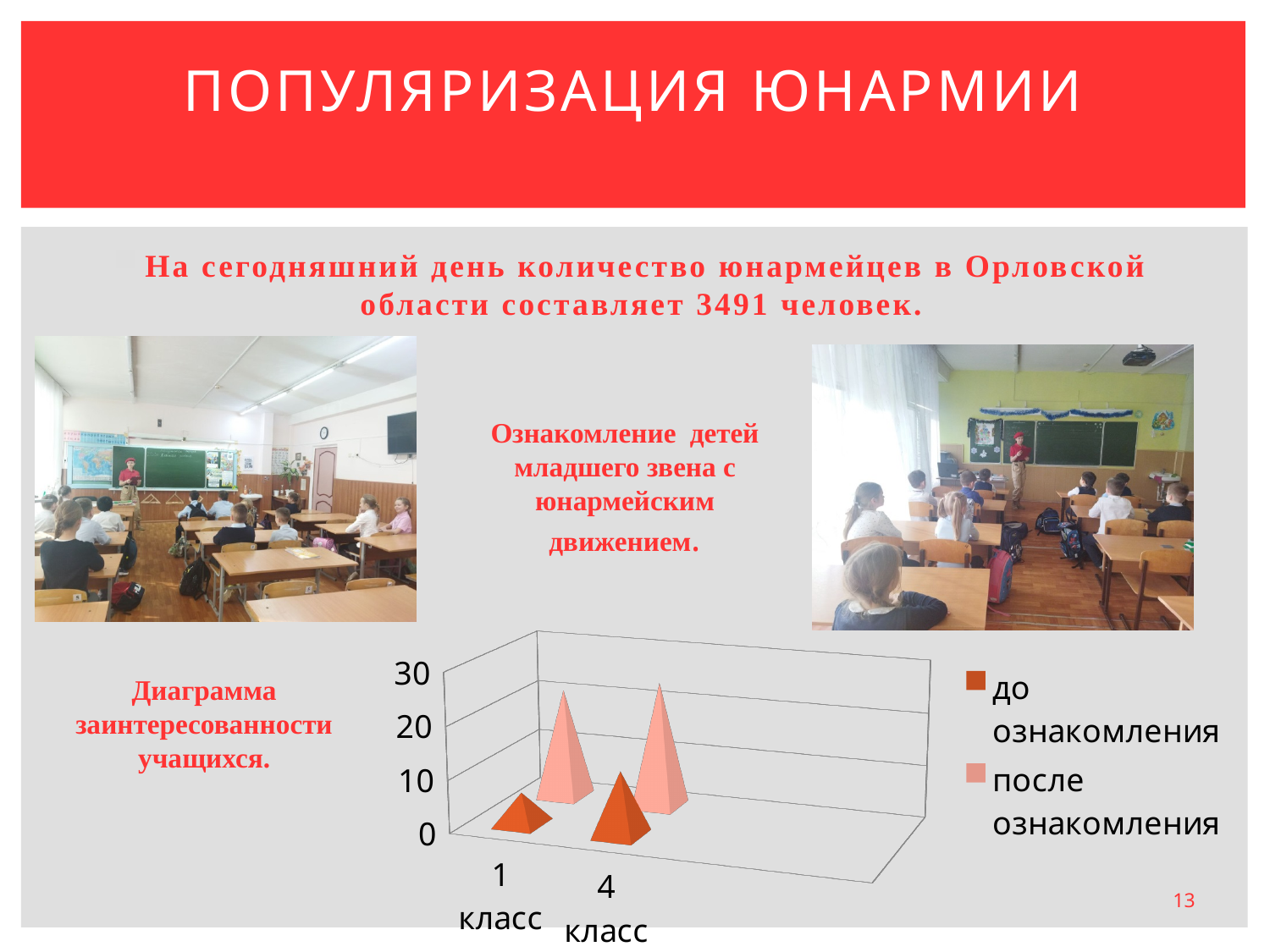
For 4 класс, which is larger: до ознакомления or после ознакомления? после ознакомления Which class has the higher value for до ознакомления? 4 класс What caption is given for the chart on the left side of the slide? Диаграмма заинтересованности учащихся. For 1 класс, which is larger: до ознакомления or после ознакомления? после ознакомления Is the value for после ознакомления in 1 класс greater or less than 10? greater How many categories (classes) are shown on the x axis of the chart? 2 Which two series are listed in the chart legend? до ознакомления, после ознакомления Which bar in the chart is the lowest? до ознакомления, 1 класс How many series does the chart legend list? 2 What kind of chart is shown on the slide? bar chart Is the value for до ознакомления in 1 класс greater or less than 10? less Is the value for после ознакомления in 4 класс greater or less than 10? greater